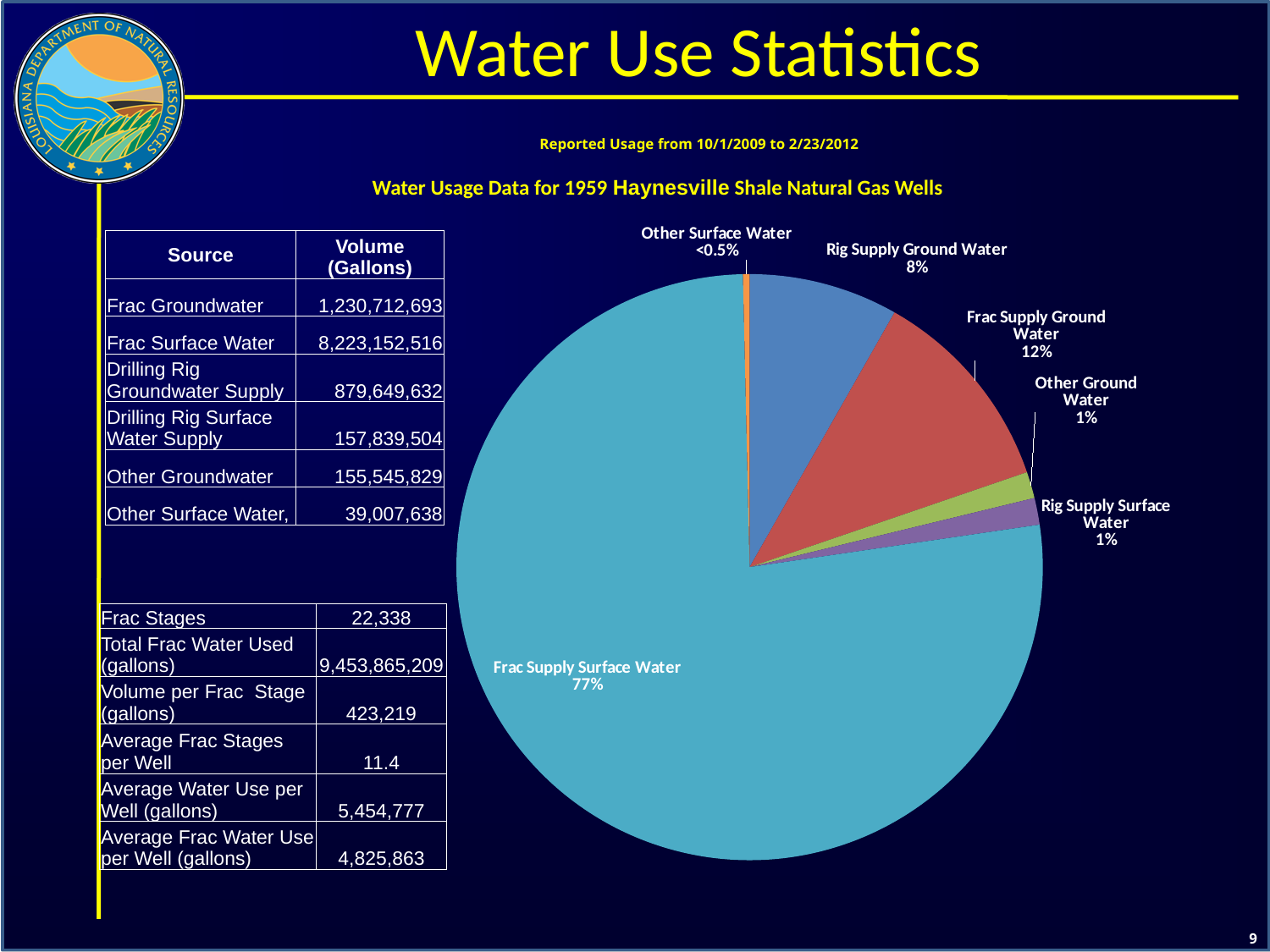
What is the difference in percentage points between Frac Supply Ground Water and Rig Supply Ground Water? 4% What share of the pie does Frac Supply Surface Water represent? 77% Which slice of the pie chart is the largest? Frac Supply Surface Water What is the difference in percentage points between Frac Supply Surface Water and Frac Supply Ground Water? 65% What kind of chart is shown on the slide? pie chart What share of the pie does Rig Supply Ground Water represent? 8% What share of the pie does Other Ground Water represent? 1% How many slices does the pie chart have? 6 What share is shown for Other Surface Water in the pie chart? <0.5% Which is larger in the pie chart, Frac Supply Ground Water or Rig Supply Ground Water? Frac Supply Ground Water Which slice of the pie chart is the smallest? Other Surface Water